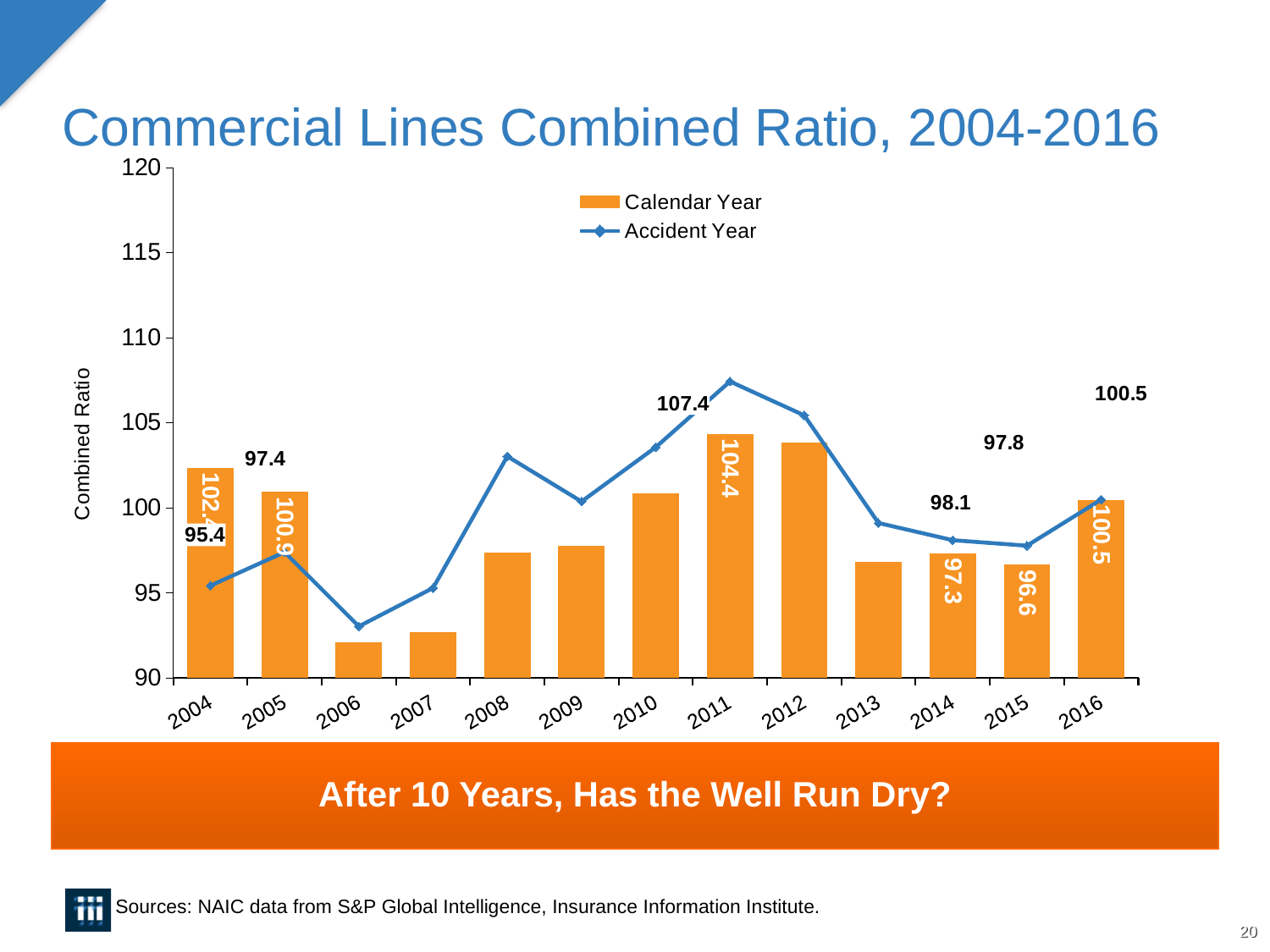
What is the Calendar Year combined ratio for 2011? 104.4 In 2014, which is larger: the Calendar Year or the Accident Year combined ratio? Accident Year How many series does the legend list? 2 What is the Calendar Year combined ratio for 2015? 96.6 Is the Calendar Year combined ratio for 2006 greater or less than 95? less Does the Accident Year combined ratio rise or fall from 2011 to 2015? fall How many years are shown on the x axis? 13 Is the Accident Year combined ratio for 2008 greater or less than 100? greater In which year is the Accident Year combined ratio highest? 2011 What is the Accident Year combined ratio for 2004? 95.4 How much higher is the Accident Year combined ratio than the Calendar Year combined ratio in 2011? 3.0 What is the Accident Year combined ratio for 2011? 107.4